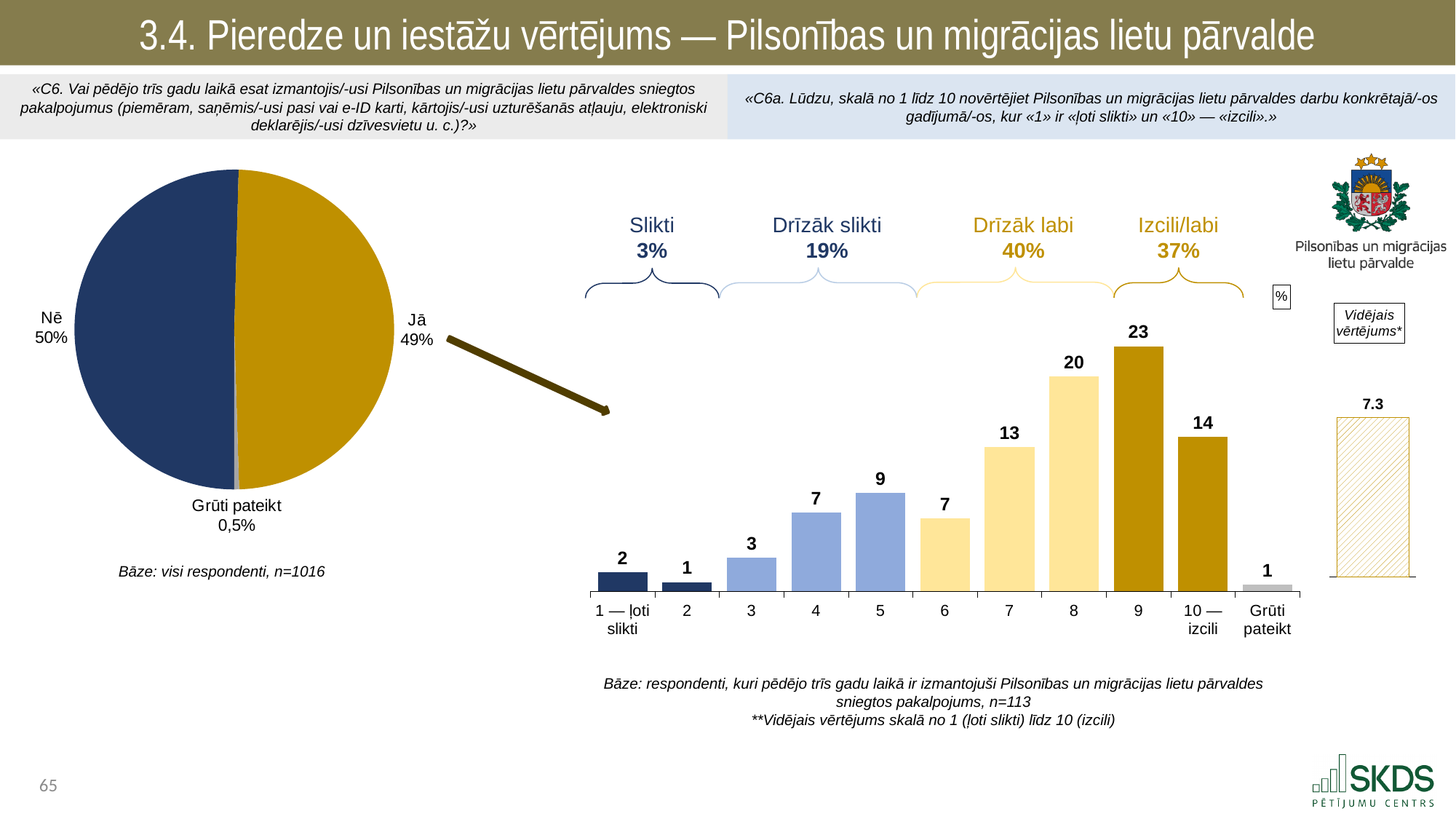
In the bar chart on the right, what is the value for rating 9? 23 In the bar chart on the right, which rating has the highest value? 9 In the bar chart on the right, what is the value for rating "10 — izcili"? 14 In the bar chart on the right, which is larger: the value for rating 5 or the value for rating 6? rating 5 What is the average rating ("Vidējais vērtējums") shown on the right of the slide? 7.3 In the pie chart on the left, which answer has the largest share? Nē In the pie chart on the left, what share of respondents answered "Jā"? 49% In the bar chart on the right, what is the difference between the values for rating 8 and rating 7? 7 In the pie chart on the left, what share of respondents answered "Grūti pateikt"? 0,5% In the bar chart on the right, what percentage is shown for the "Drīzāk labi" group? 40% In the pie chart on the left, how many slices are there? 3 In the bar chart on the right, how many rating categories are shown on the x axis, including "Grūti pateikt"? 11